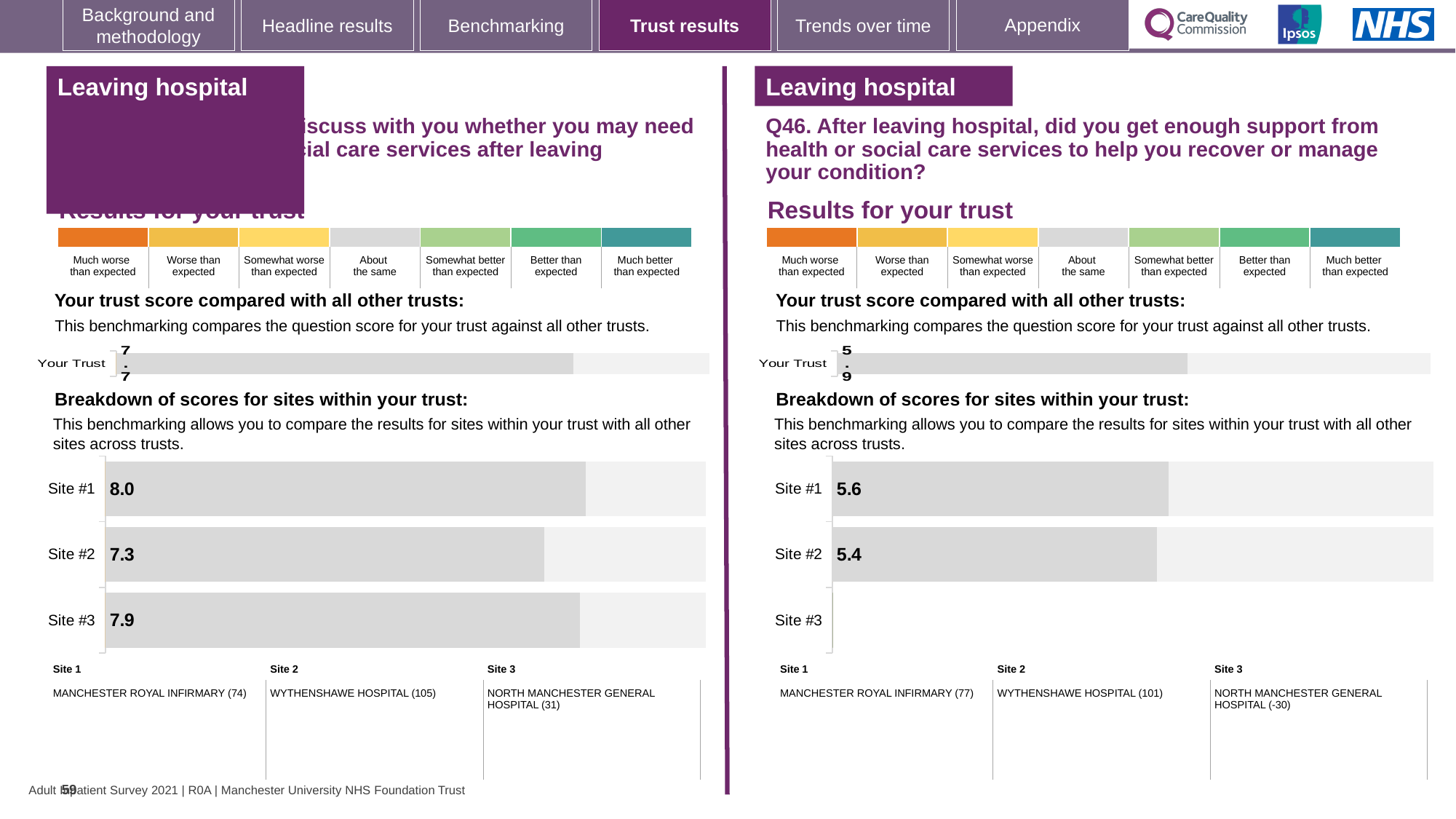
On the left-hand chart, what is the score for Site #1? 8.0 On the left-hand chart, what is the difference between the scores for Site #1 and Site #2? 0.7 On the left-hand chart, which site has the highest score? Site #1 On the right-hand chart for Q46, what is the 'Your Trust' score? 5.9 On the left-hand chart, which site has the lowest score? Site #2 On the left-hand chart, what is the score for Site #2? 7.3 On the right-hand chart for Q46, which is larger, the score for Site #1 or Site #2? Site #1 What kind of chart is used to show the breakdown of scores for sites on the right-hand side? Bar chart On the right-hand chart for Q46, what is the score for Site #1? 5.6 On the right-hand chart for Q46, what is the score for Site #2? 5.4 On the left-hand chart, what is the score for Site #3? 7.9 On the left-hand chart, what is the 'Your Trust' score? 7.7